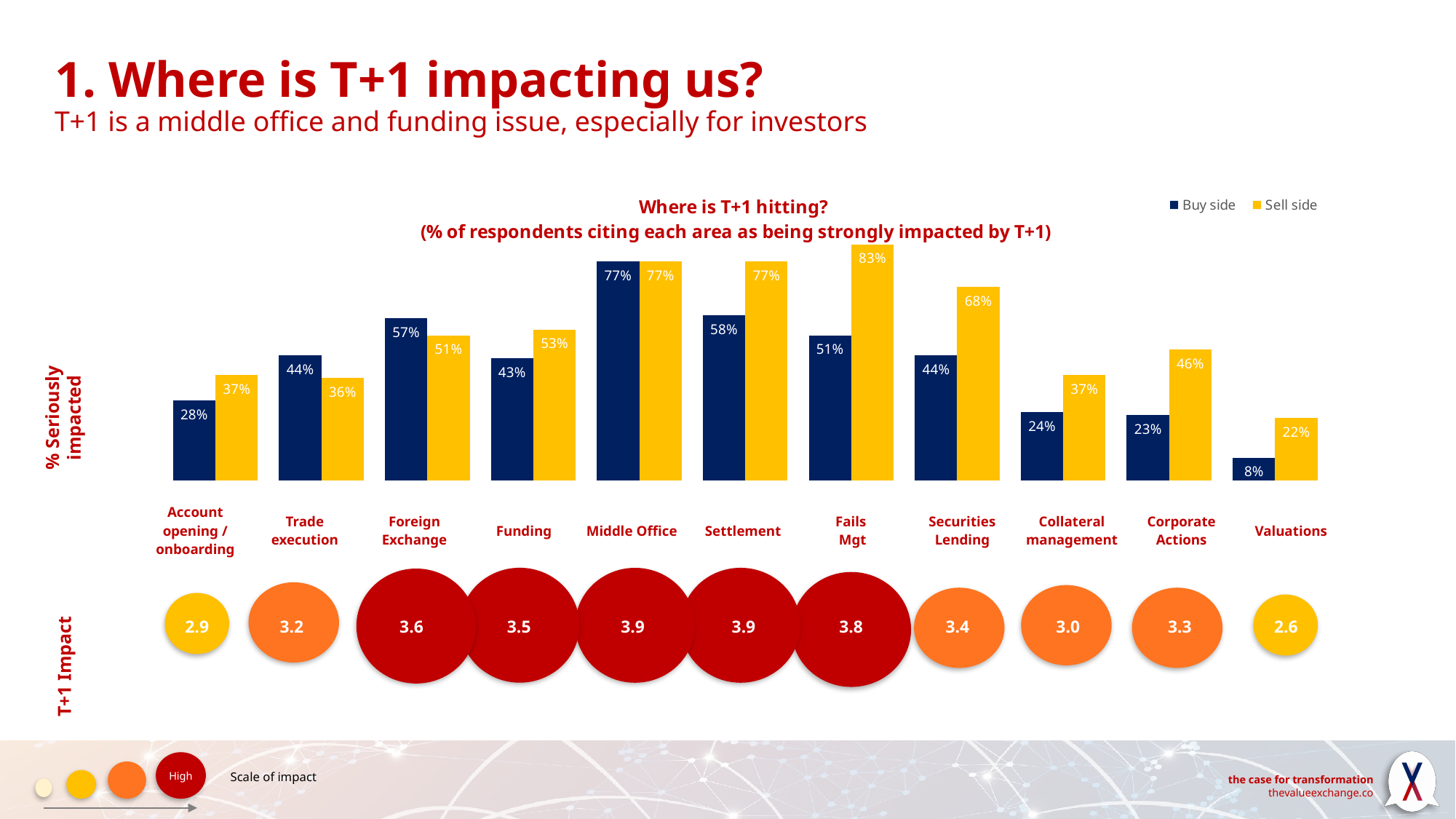
What is the T+1 Impact score shown for Settlement? 3.9 Which category has the highest Sell side value? Fails Mgt What is the Buy side value for Middle Office? 77% What is the Sell side value for Fails Mgt? 83% What is the difference between the Sell side and Buy side values for Fails Mgt? 32% Which category has the lowest Buy side value? Valuations What kind of chart is used to show the % seriously impacted? Bar chart How many categories are shown on the x axis of the bar chart? 11 How many series does the legend list? 2 What is the title of the bar chart? Where is T+1 hitting? What is the Buy side value for Valuations? 8% Which is larger for Foreign Exchange, the Buy side value or the Sell side value? Buy side